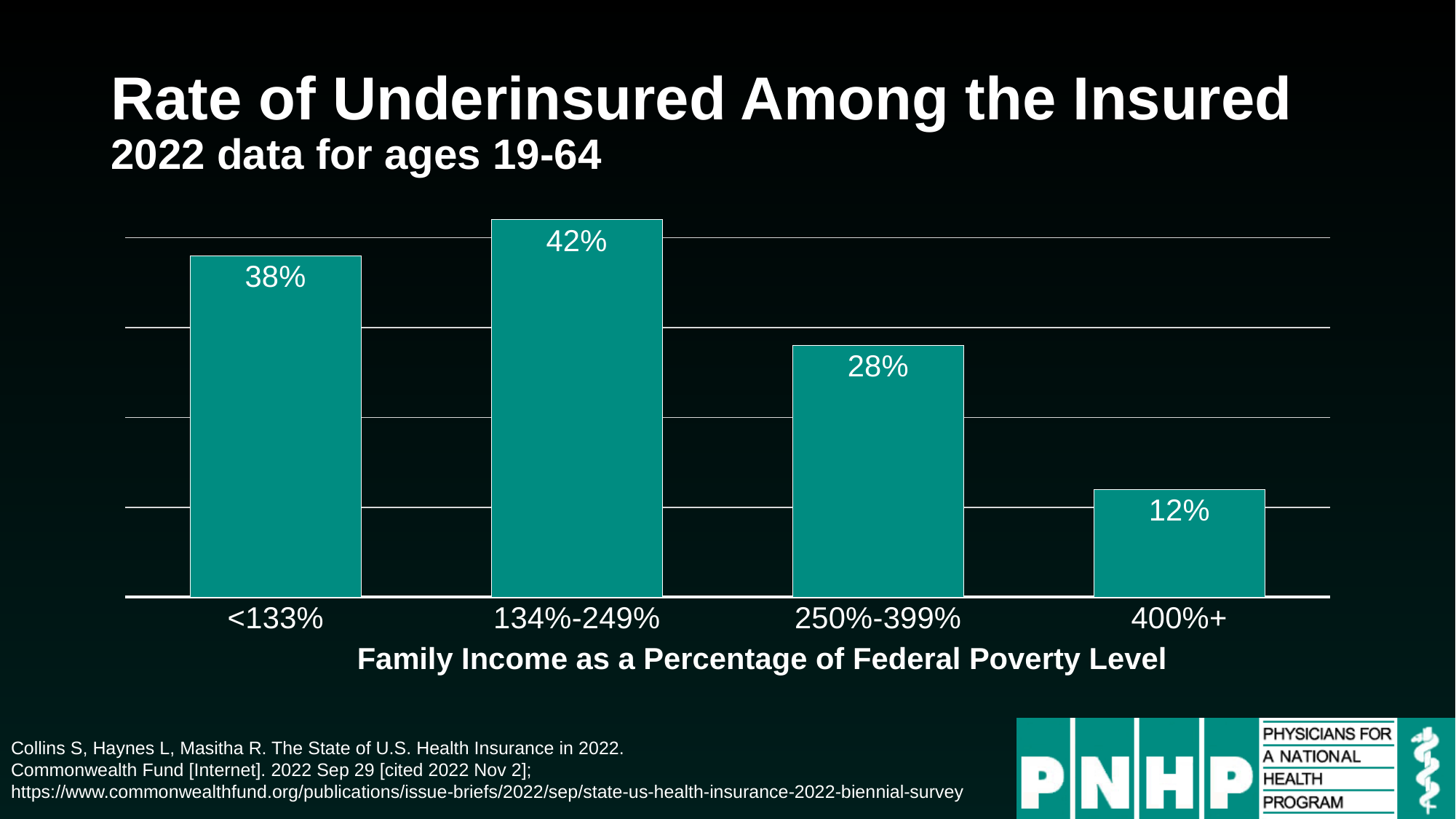
What is the difference between the rate for the 134%-249% group and the 400%+ group? 30% What is the rate of underinsured for the 250%-399% family income group? 28% What is the label of the x axis? Family Income as a Percentage of Federal Poverty Level Which family income group has the lowest rate of underinsured? 400%+ What is the rate of underinsured for the 400%+ family income group? 12% How many family income groups are shown in the chart? 4 What is the rate of underinsured for the 134%-249% family income group? 42% Which has a higher rate of underinsured, the <133% group or the 250%-399% group? <133% What is the rate of underinsured for the <133% family income group? 38% What is the difference between the rate for the <133% group and the 250%-399% group? 10% What kind of chart is shown on the slide? Bar chart Which family income group has the highest rate of underinsured? 134%-249%